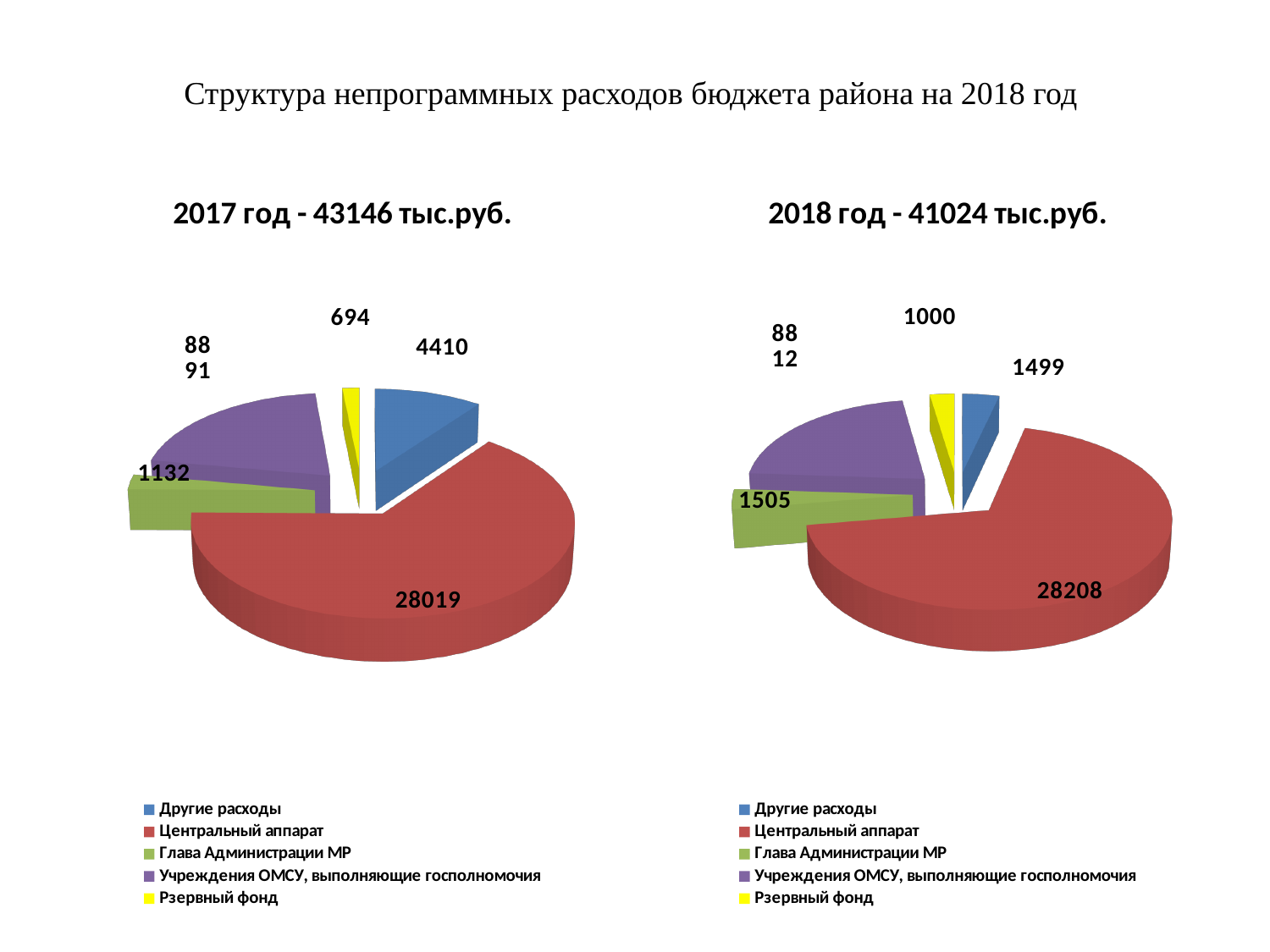
In the 2017 год chart, which category has the smallest slice? Рзервный фонд In the 2018 год chart, which category has the largest slice? Центральный аппарат In the 2017 год chart, which is larger: Другие расходы or Глава Администрации МР? Другие расходы In the 2017 год chart, what is the value for Рзервный фонд? 694 In the 2018 год chart, what is the value for Другие расходы? 1499 What is the difference between the Центральный аппарат value in the 2018 год chart and in the 2017 год chart? 189 What total is given in the title of the left chart for 2017 год? 43146 тыс.руб. In the 2017 год chart, what is the value for Центральный аппарат? 28019 What is the difference between the Другие расходы value in the 2017 год chart and in the 2018 год chart? 2911 What type of chart is used on this slide? Pie chart In the 2018 год chart, what is the value for Глава Администрации МР? 1505 How many categories does the legend of the 2018 год chart list? 5